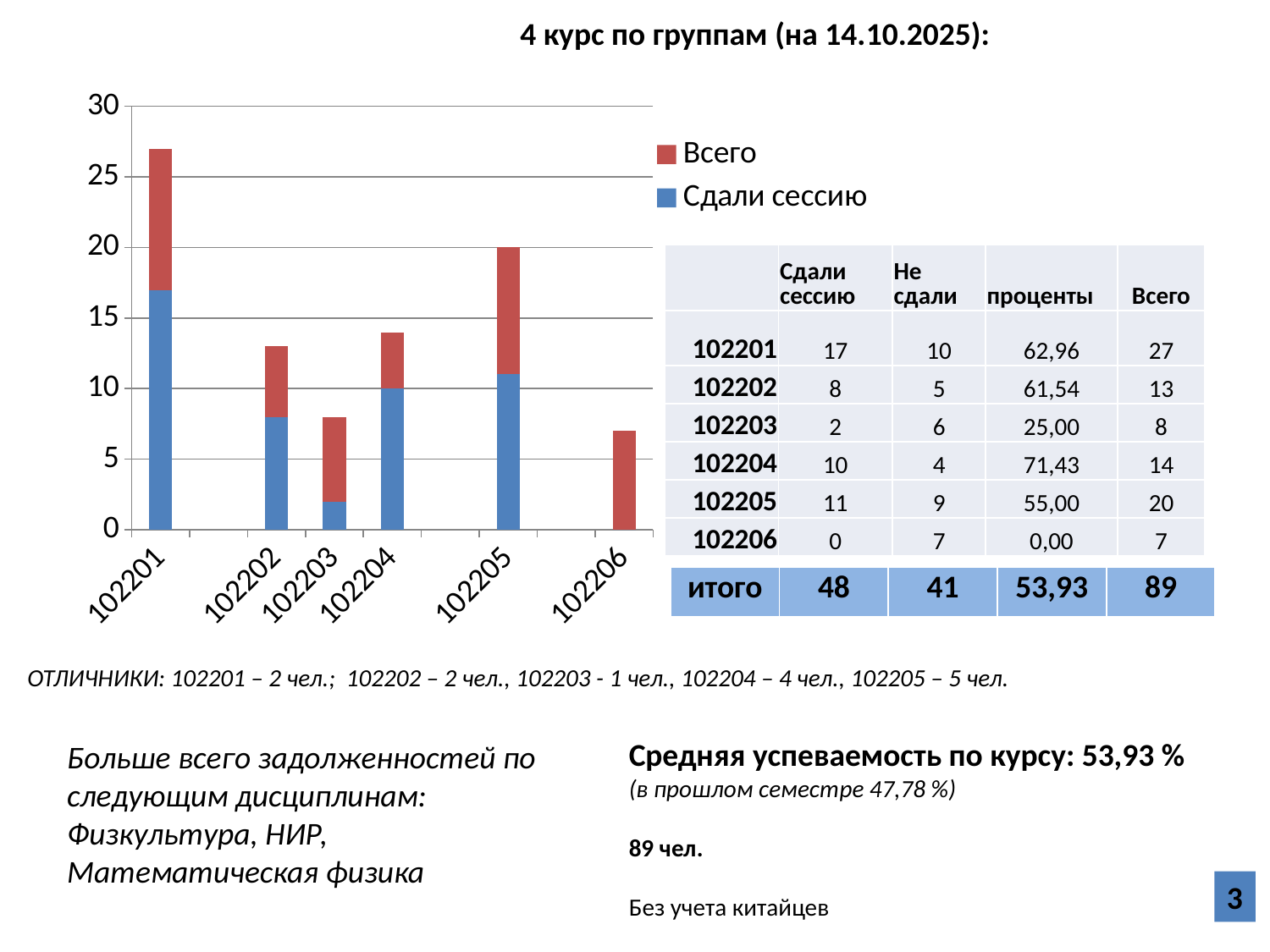
How many series does the chart legend list? 2 What is the value of the Сдали сессию segment for group 102204? 10 What is the total height of the bar for group 102205? 20 What is the value of the Сдали сессию segment for group 102206? 0 What kind of chart is shown on the slide? Stacked bar chart What are the two series named in the chart legend? Всего and Сдали сессию Is the total bar height for group 102203 greater or less than 10? less Is the total bar height for group 102201 greater or less than 25? greater Which group has the tallest bar in the chart? 102201 Which group has the shortest bar in the chart? 102206 Which bar is taller, 102202 or 102204? 102204 How many groups are shown on the x axis of the chart? 6